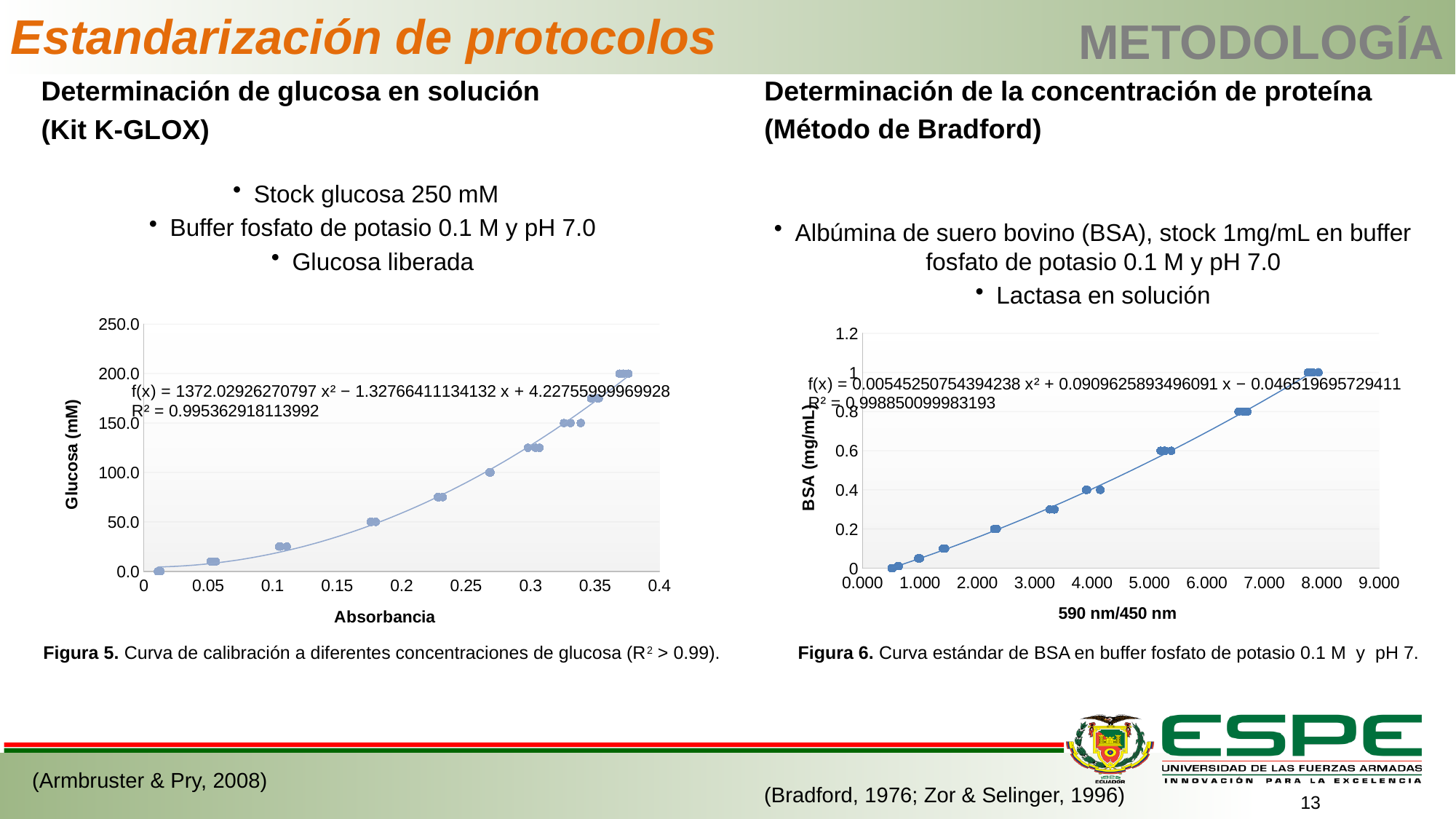
In Figura 5 (left chart), is the glucose value at an absorbance of about 0.1 greater or less than 50.0? less In Figura 5 (left chart), which has the larger glucose value: the point at absorbance about 0.3 or the point at absorbance about 0.18? the point at absorbance about 0.3 What R² value is printed on Figura 5 (the left chart)? 0.995362918113992 In Figura 5 (left chart), do the glucose values rise or fall as absorbance increases along the x axis? rise What is the y-axis title of Figura 6 (the right chart)? BSA (mg/mL) In Figura 6 (right chart), is the BSA value at a ratio of about 2.300 greater or less than 0.4? less In Figura 6 (right chart), do the BSA values rise or fall as the 590 nm/450 nm ratio increases along the x axis? rise In Figura 5 (left chart), is the glucose value at an absorbance of about 0.35 greater or less than 150.0? greater What kind of chart is Figura 6 (the right chart, BSA vs 590 nm/450 nm)? scatter chart In Figura 6 (right chart), which has the larger BSA value: the point at a ratio of about 5.300 or the point at a ratio of about 1.400? the point at a ratio of about 5.300 What kind of chart is Figura 5 (the left chart, Glucosa vs Absorbancia)? scatter chart